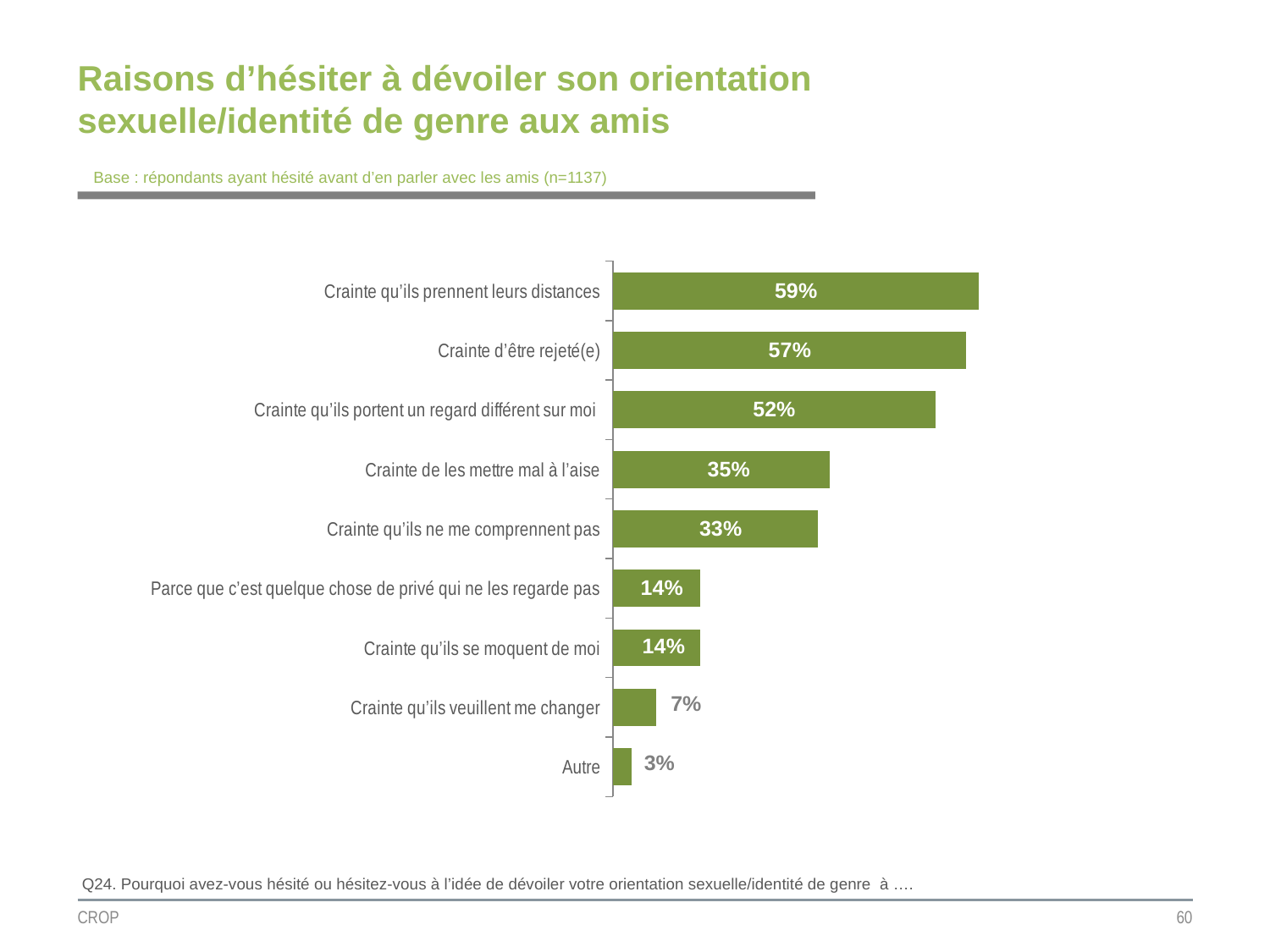
What percentage is shown for "Crainte qu'ils prennent leurs distances"? 59% What value is shown for "Autre"? 3% What value is shown for "Crainte de les mettre mal à l'aise"? 35% Which is larger: "Crainte de les mettre mal à l'aise" or "Crainte qu'ils ne me comprennent pas"? Crainte de les mettre mal à l'aise Which category has the highest value? Crainte qu'ils prennent leurs distances What is the difference between "Crainte qu'ils ne me comprennent pas" and "Crainte qu'ils se moquent de moi"? 19% What is the difference between "Crainte d'être rejeté(e)" and "Crainte qu'ils portent un regard différent sur moi"? 5% What kind of chart is shown on the slide? Bar chart Which category has the lowest value? Autre How many categories are shown in the chart? 9 What percentage is shown for "Crainte qu'ils veuillent me changer"? 7% What is the base size (n) stated for the chart? n=1137